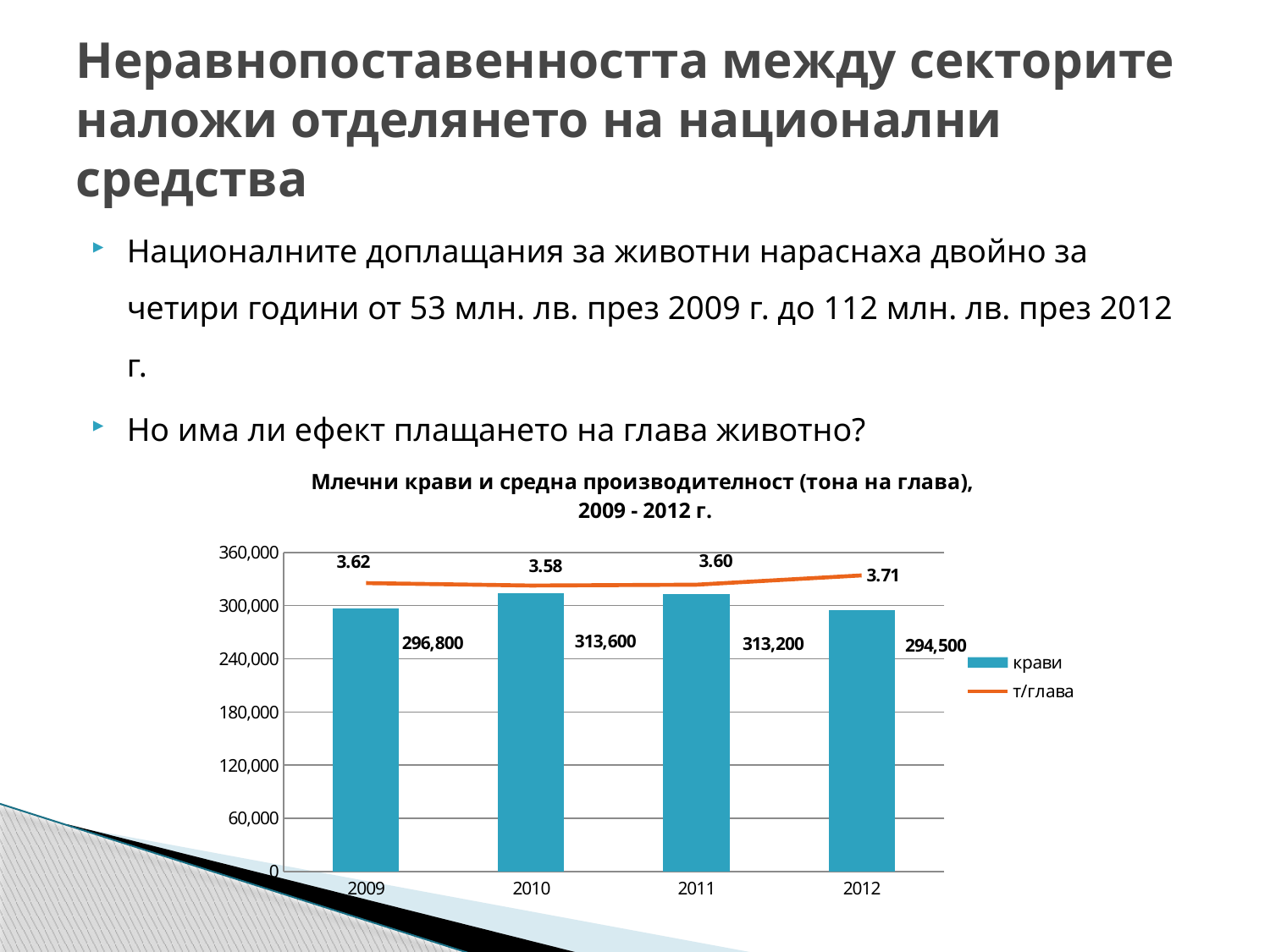
What is the number of cows (крави) in 2010? 313,600 What is the difference in the number of cows (крави) between 2010 and 2012? 19,100 What is the value of т/глава in 2012? 3.71 How many years are shown on the x axis? 4 How many series does the legend list? 2 Is the number of cows (крави) in 2009 greater or less than 300,000? less What kind of chart is this? Combined bar and line chart Which year has the highest number of cows (крави)? 2010 Which year has the highest value of т/глава? 2012 What is the number of cows (крави) in 2012? 294,500 Which is larger, the number of cows (крави) in 2009 or in 2012? 2009 Which year has the lowest value of т/глава? 2010